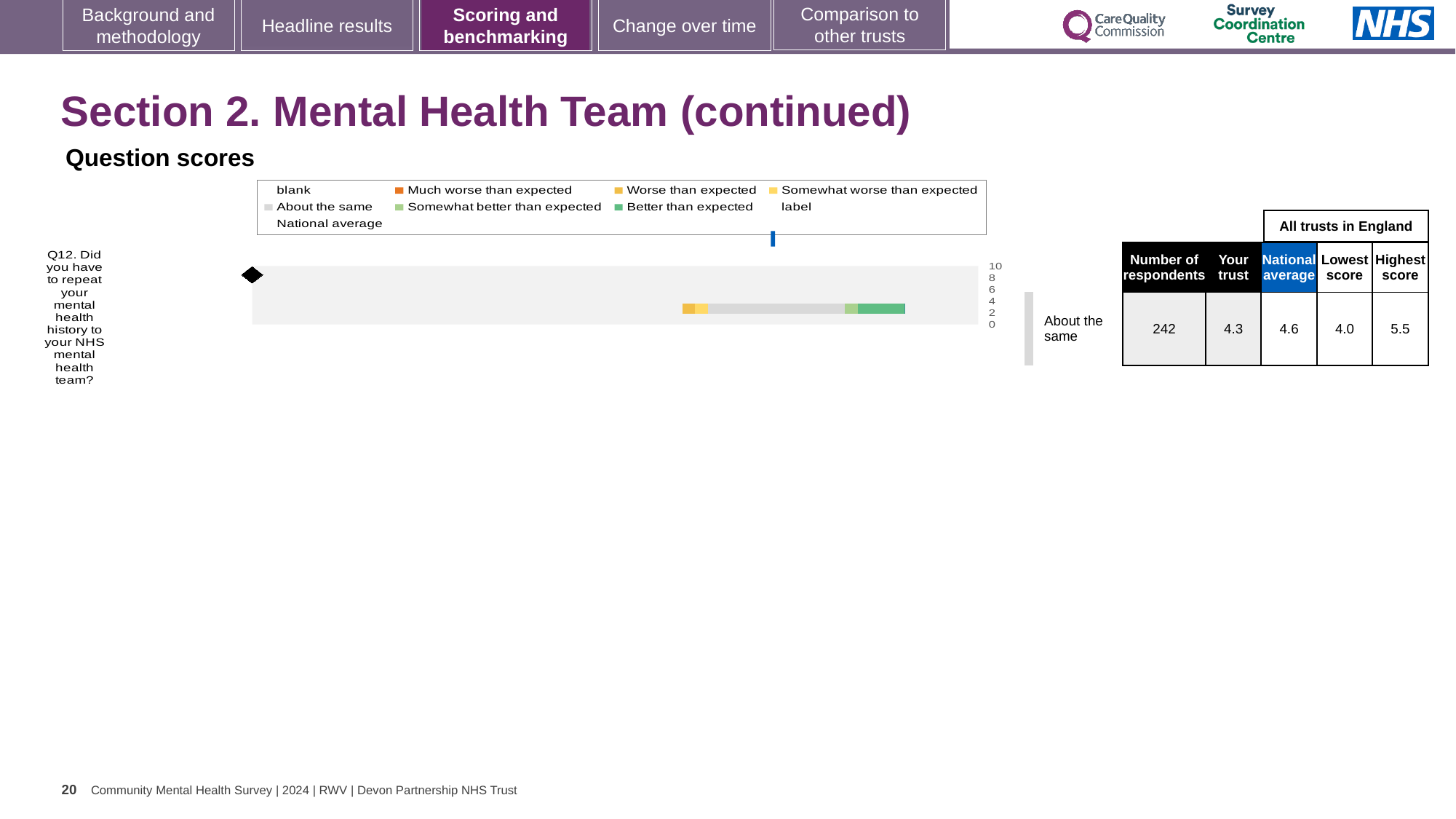
What is the highest score among all trusts in England for Q12? 5.5 How many survey questions are plotted on the chart? 1 What is the difference between the national average and the 'Your trust' score for Q12? 0.3 What is the national average score for Q12? 4.6 What colour does the legend use for 'Better than expected'? Green What is the difference between the highest score and the lowest score for Q12? 1.5 Which benchmarking category is the trust's Q12 score placed in? About the same What is the 'Your trust' score for Q12 shown next to the chart? 4.3 What kind of chart is used to show the Q12 question score? bar chart What is the lowest score among all trusts in England for Q12? 4.0 How many respondents answered Q12? 242 Which is larger for Q12, the 'Your trust' score or the national average? National average